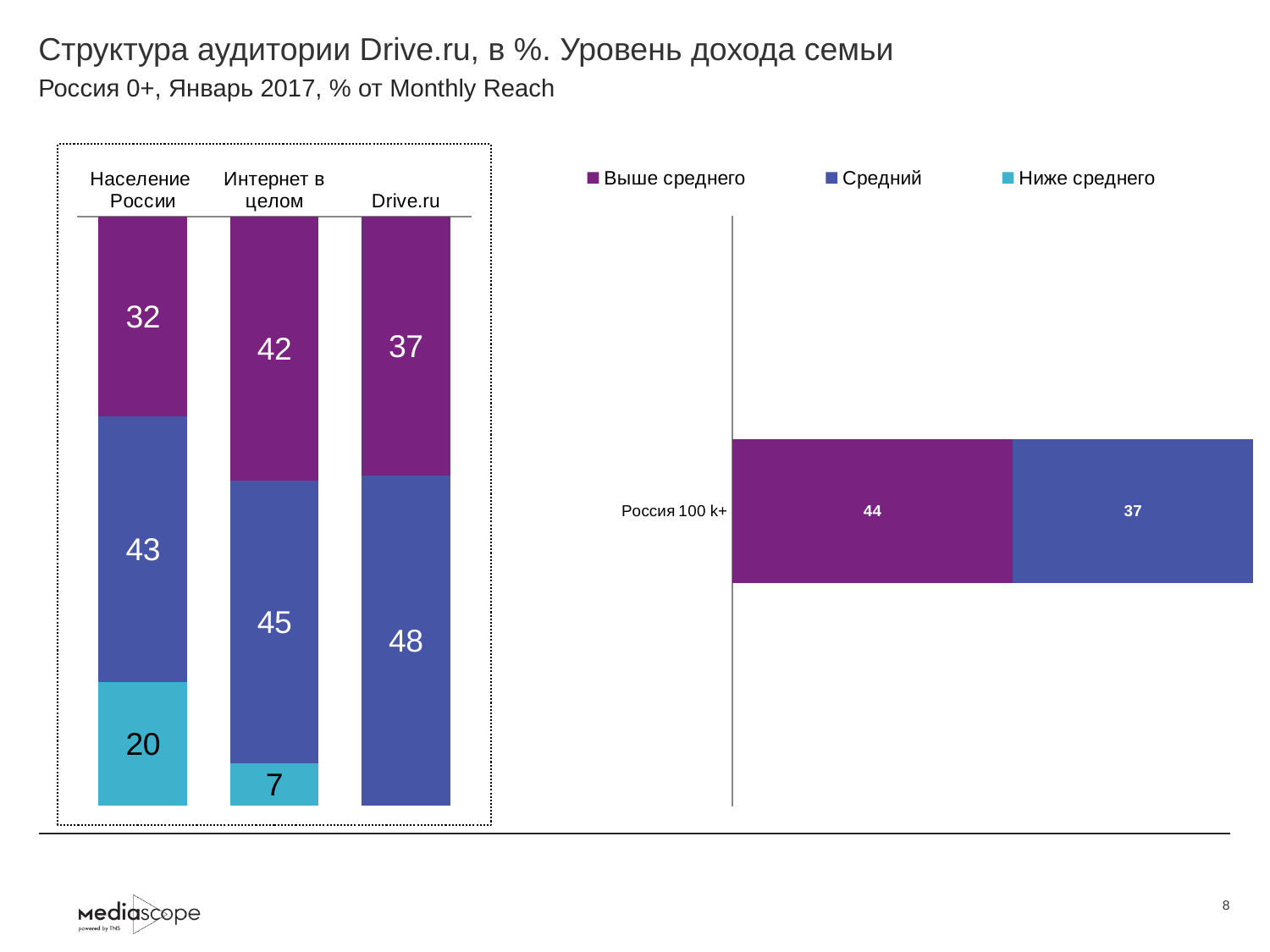
In the right chart, what is the 'Выше среднего' value for 'Россия 100 k+'? 44 In the right chart, what is the total of the two labelled segments for 'Россия 100 k+'? 81 In the left stacked bar chart, which category has the lowest 'Ниже среднего' value among those with a labelled 'Ниже среднего' segment? Интернет в целом In the left stacked bar chart, what is the difference between the 'Средний' values for 'Drive.ru' and 'Население России'? 5 How many series does the legend list? 3 In the left stacked bar chart, which category has the highest 'Выше среднего' value? Интернет в целом How many categories are shown in the left stacked bar chart? 3 In the left stacked bar chart, what is the value of the 'Средний' segment for 'Интернет в целом'? 45 In the left stacked bar chart, which is larger: the 'Выше среднего' value for 'Drive.ru' or for 'Население России'? Drive.ru In the left stacked bar chart, what is the value of the 'Средний' segment for 'Drive.ru'? 48 In the left stacked bar chart, what is the value of the 'Выше среднего' segment for 'Население России'? 32 In the left stacked bar chart, what is the value of the 'Ниже среднего' segment for 'Население России'? 20